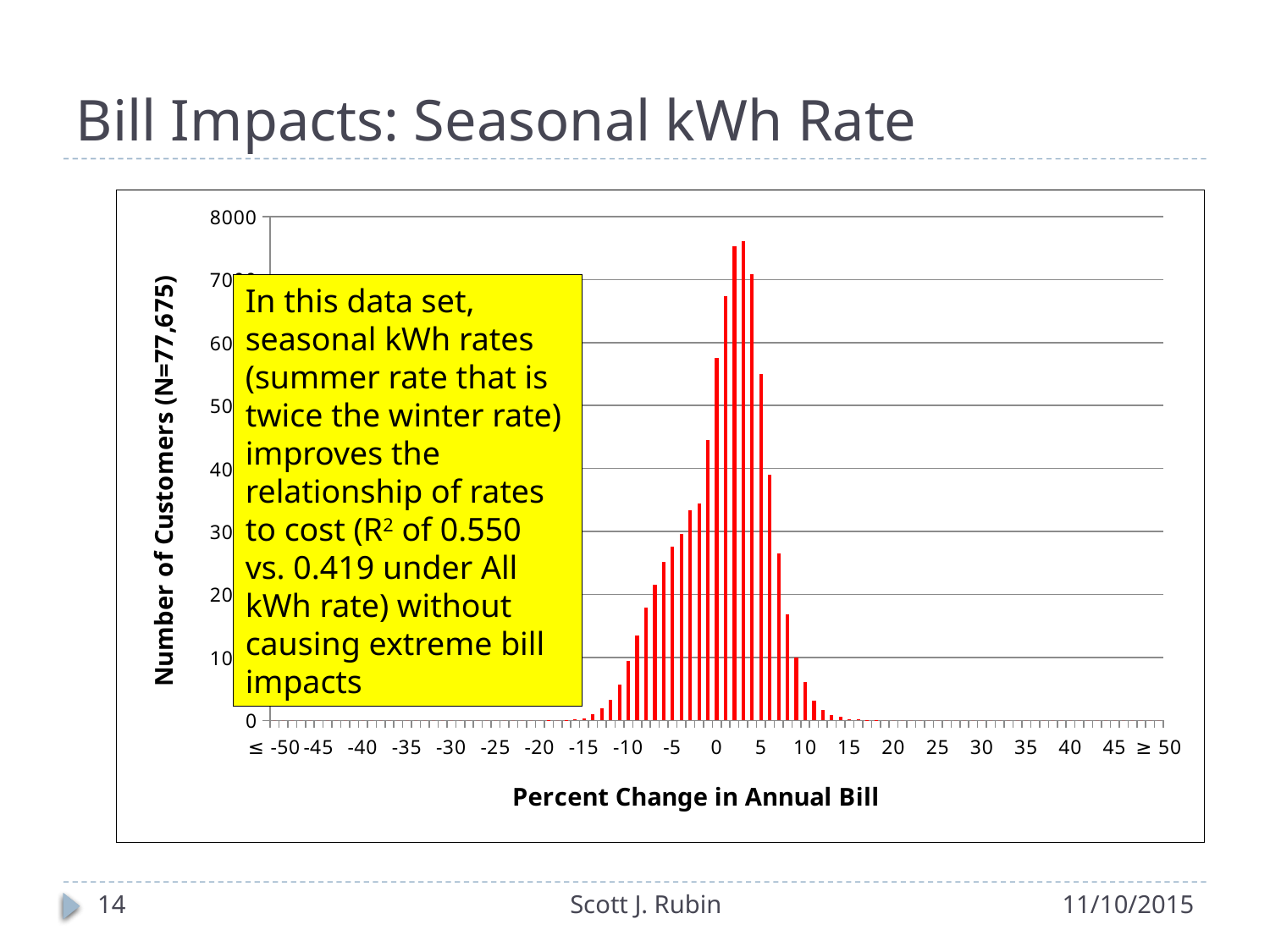
According to the y-axis title, how many customers (N) are in the data set? 77,675 Do the bar heights rise or fall as the percent change in annual bill goes from -20 to 0? rise What kind of chart is shown on the slide? bar chart Is the number of customers at a 20 percent change in annual bill greater or less than 1000? less Do the bar heights rise or fall as the percent change in annual bill goes from 5 to 20? fall Is the tallest bar in the chart greater or less than 7000? greater Is the number of customers at a -10 percent change in annual bill greater or less than 2000? less What is the title of the x axis of the chart? Percent Change in Annual Bill